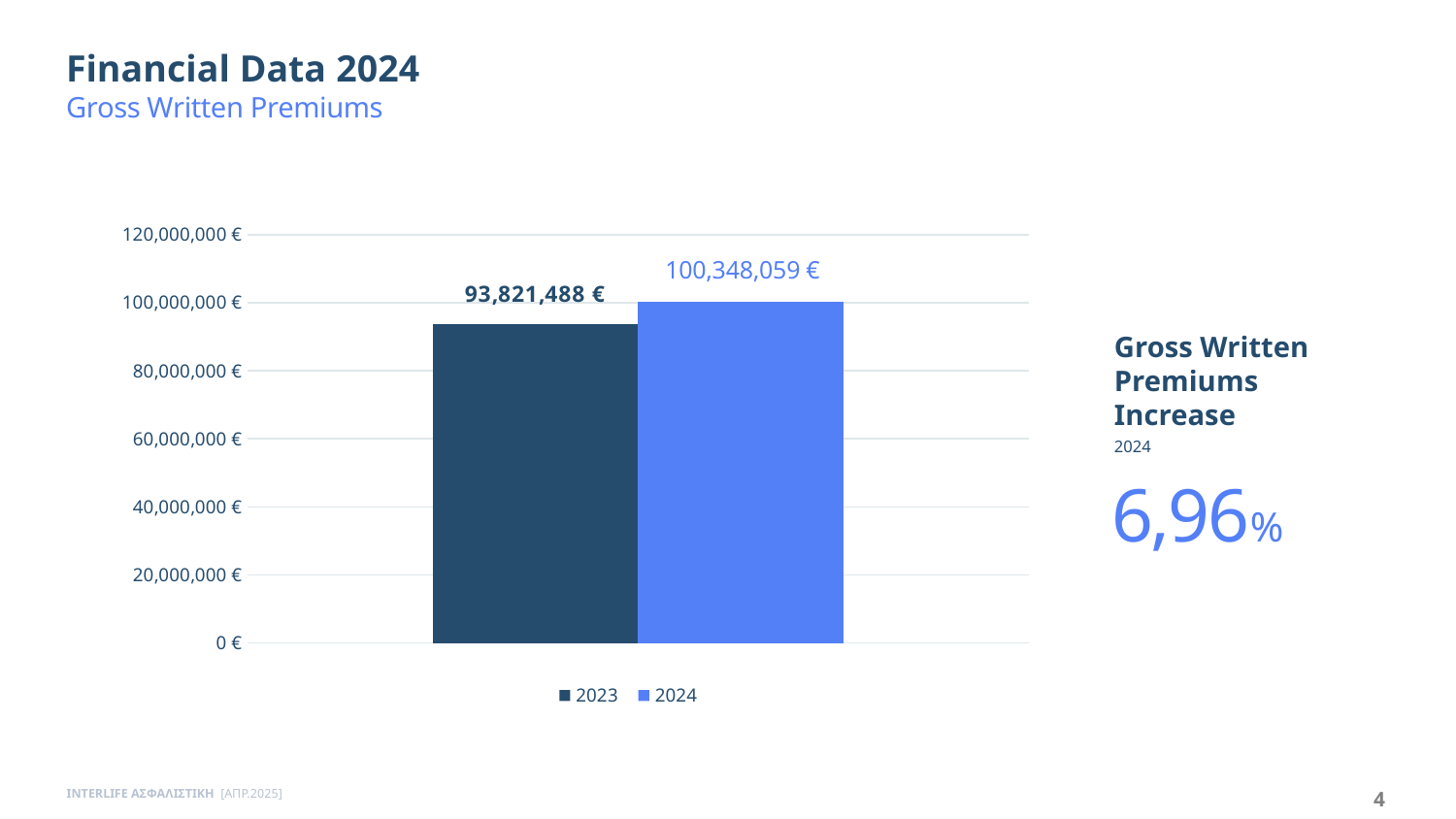
What kind of chart is shown on the slide? Bar chart Do the Gross Written Premiums rise or fall from 2023 to 2024? Rise How many series does the legend list? 2 What is the value of Gross Written Premiums for 2024? 100,348,059 € Is the value for 2023 greater or less than 100,000,000 €? less What is the value of Gross Written Premiums for 2023? 93,821,488 € Which year shows the lowest Gross Written Premiums? 2023 What is the maximum value shown on the vertical axis? 120,000,000 € Which year has the higher Gross Written Premiums, 2023 or 2024? 2024 What percentage increase in Gross Written Premiums is stated on the slide for 2024? 6,96% Is the value for 2024 greater or less than 100,000,000 €? greater What is the difference between the 2024 and 2023 Gross Written Premiums? 6,526,571 €